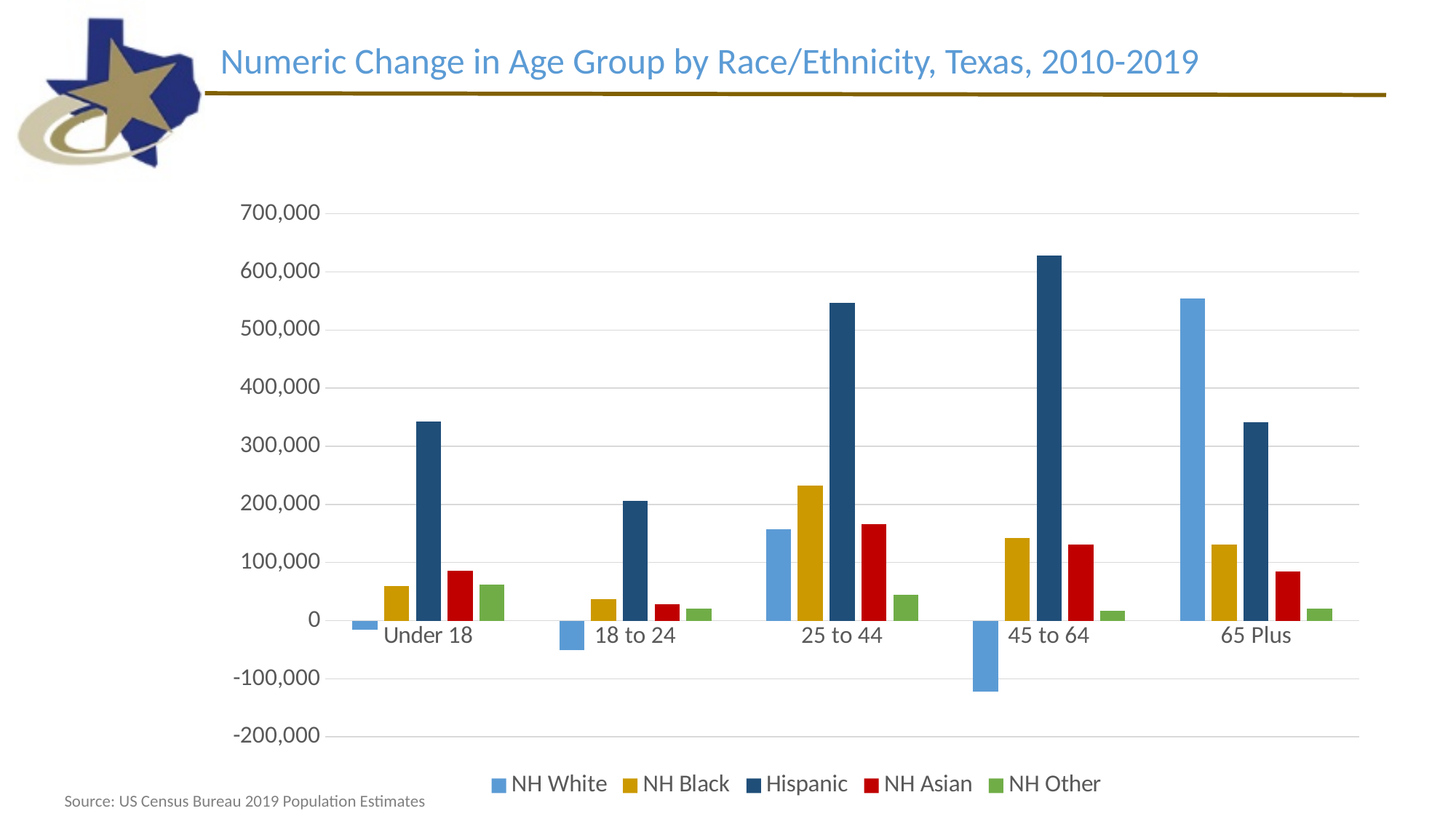
Is the Hispanic value for 45 to 64 greater or less than 600,000? greater In which age group is the NH White value the lowest? 45 to 64 Which series has the highest value in the Under 18 age group? Hispanic How many age groups are shown on the x axis? 5 Is the NH White value for 45 to 64 greater or less than -100,000? less In the 65 Plus age group, which is larger: NH White or Hispanic? NH White In which age group is the Hispanic value the highest? 45 to 64 What kind of chart is shown on the slide? bar chart How many series does the legend list? 5 Is the NH White value for 65 Plus greater or less than 500,000? greater What is the title of the chart? Numeric Change in Age Group by Race/Ethnicity, Texas, 2010-2019 In the 25 to 44 age group, which is larger: NH Black or NH Asian? NH Black